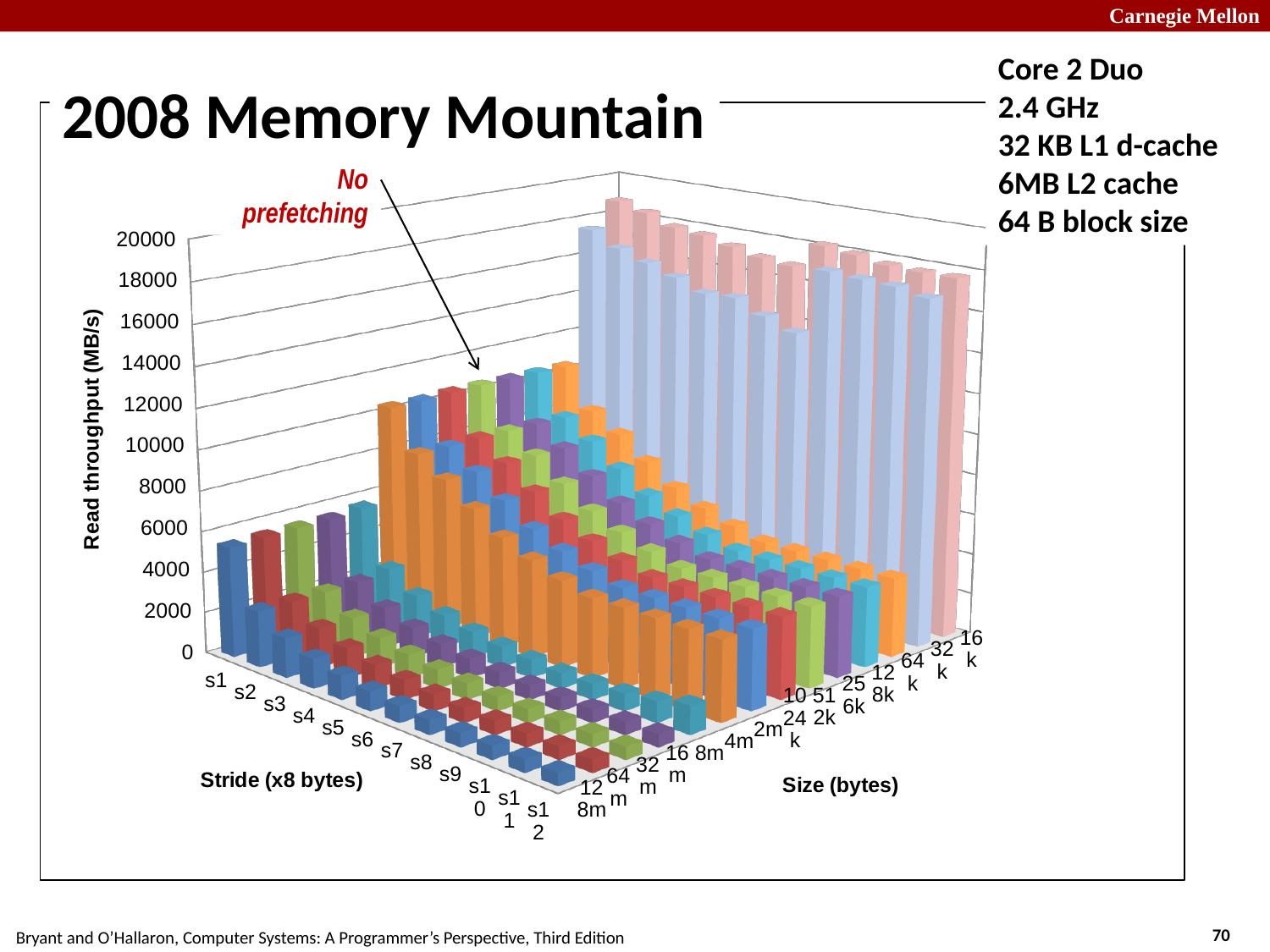
What is the title of the chart? 2008 Memory Mountain How many stride categories are shown along the stride axis? 12 For the largest size (front row), which stride has the lowest read throughput? s12 What is the highest tick value shown on the read throughput axis? 20000 Is the read throughput for stride s12 in the front row (largest size) greater or less than 4000? less Is the read throughput for stride s1 in the front row (largest size) greater or less than 10000? less Which is larger: the read throughput at stride s1 for size 16k or at stride s1 for the largest size in the front row? 16k For the largest size (front row), does read throughput rise or fall as the stride increases from s1 to s12? fall Is the read throughput for stride s1 at size 16k greater or less than 14000? greater What is the label of the vertical axis? Read throughput (MB/s) What kind of chart is shown on the slide? 3D bar chart For the largest size (front row), which stride has the highest read throughput? s1